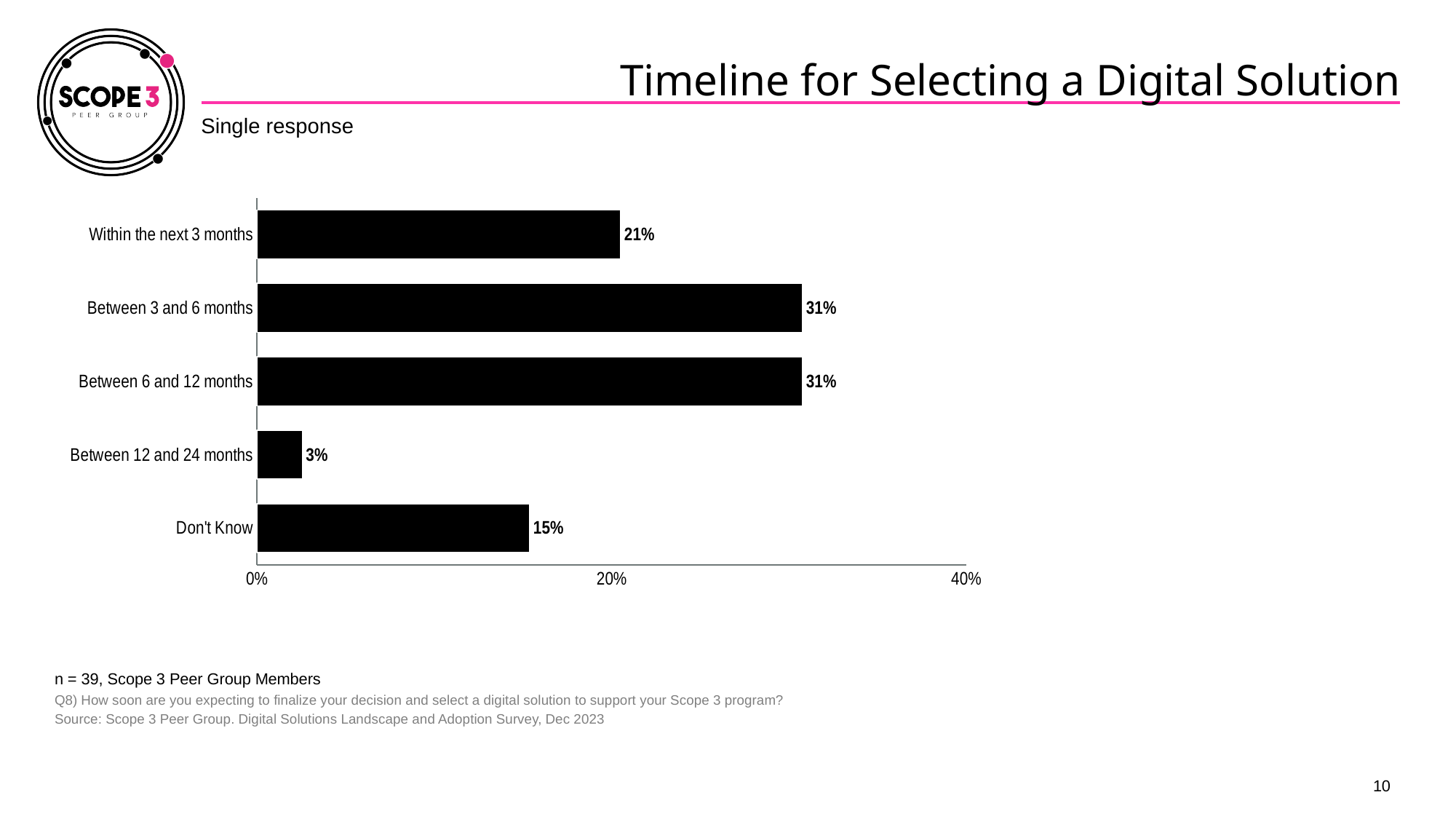
What percentage of respondents answered 'Don't Know'? 15% What is the difference between the values for 'Don't Know' and 'Between 12 and 24 months'? 12% Is the value for 'Between 3 and 6 months' greater or less than 20%? greater How many categories are shown in the chart? 5 Which is larger, the value for 'Within the next 3 months' or the value for 'Don't Know'? Within the next 3 months What is the value for 'Between 6 and 12 months'? 31% What percentage of respondents expect to select a digital solution within the next 3 months? 21% What is the title of the chart on the slide? Timeline for Selecting a Digital Solution Which category has the lowest value? Between 12 and 24 months What kind of chart is shown on the slide? Bar chart What is the value for 'Between 12 and 24 months'? 3% What is the difference between the values for 'Between 3 and 6 months' and 'Within the next 3 months'? 10%